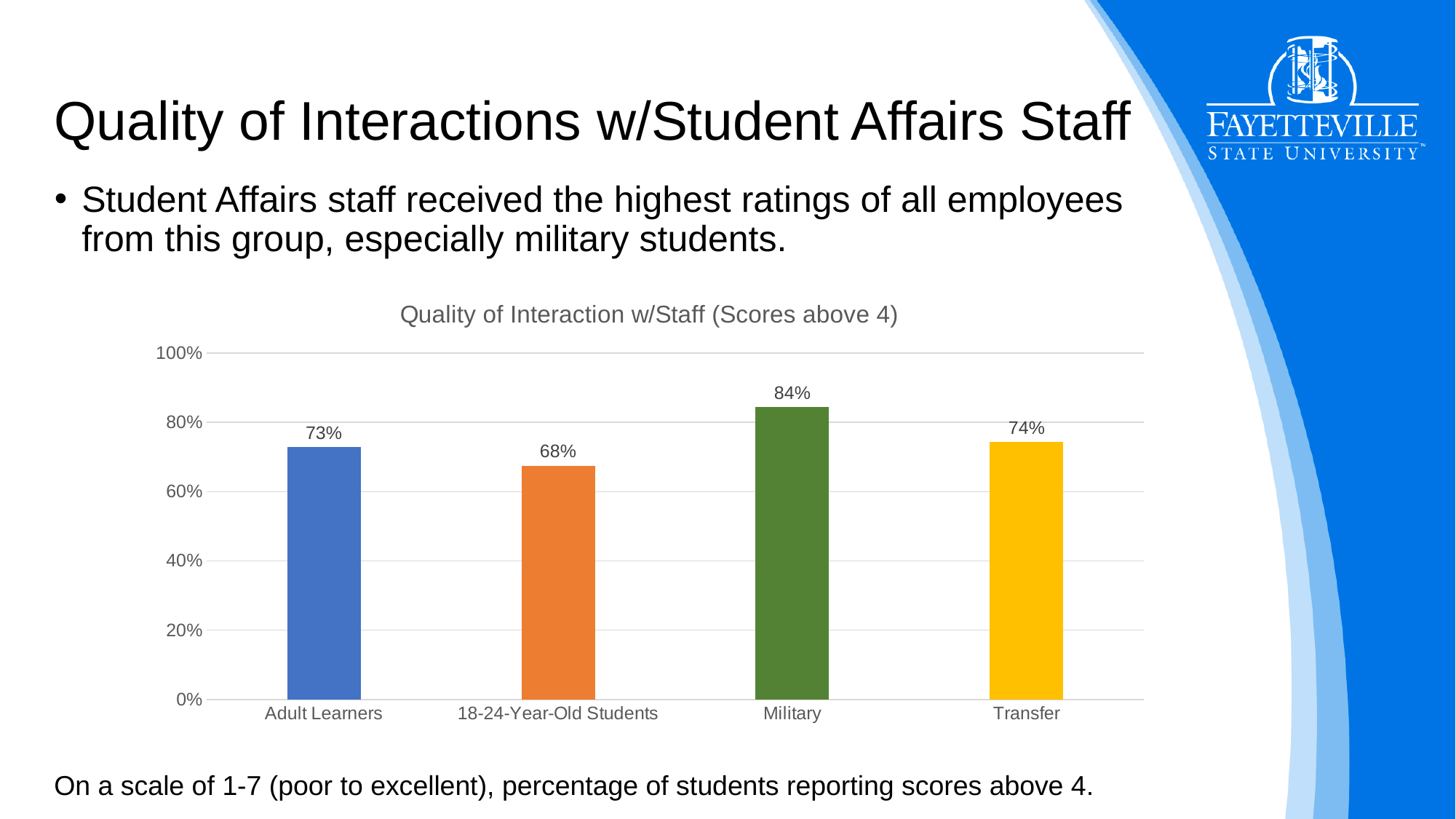
Which is larger, the value for Military or the value for Transfer? Military What is the difference between the values for Military and 18-24-Year-Old Students? 16% What is the value for Adult Learners in the chart? 73% Which category has the lowest value in the chart? 18-24-Year-Old Students What is the value for 18-24-Year-Old Students in the chart? 68% How many categories are shown in the chart? 4 Which category has the highest value in the chart? Military What is the difference between the values for Transfer and Adult Learners? 1% What kind of chart is shown on the slide? Bar chart What is the value for Military in the chart? 84% What is the title of the chart? Quality of Interaction w/Staff (Scores above 4) What is the value for Transfer in the chart? 74%